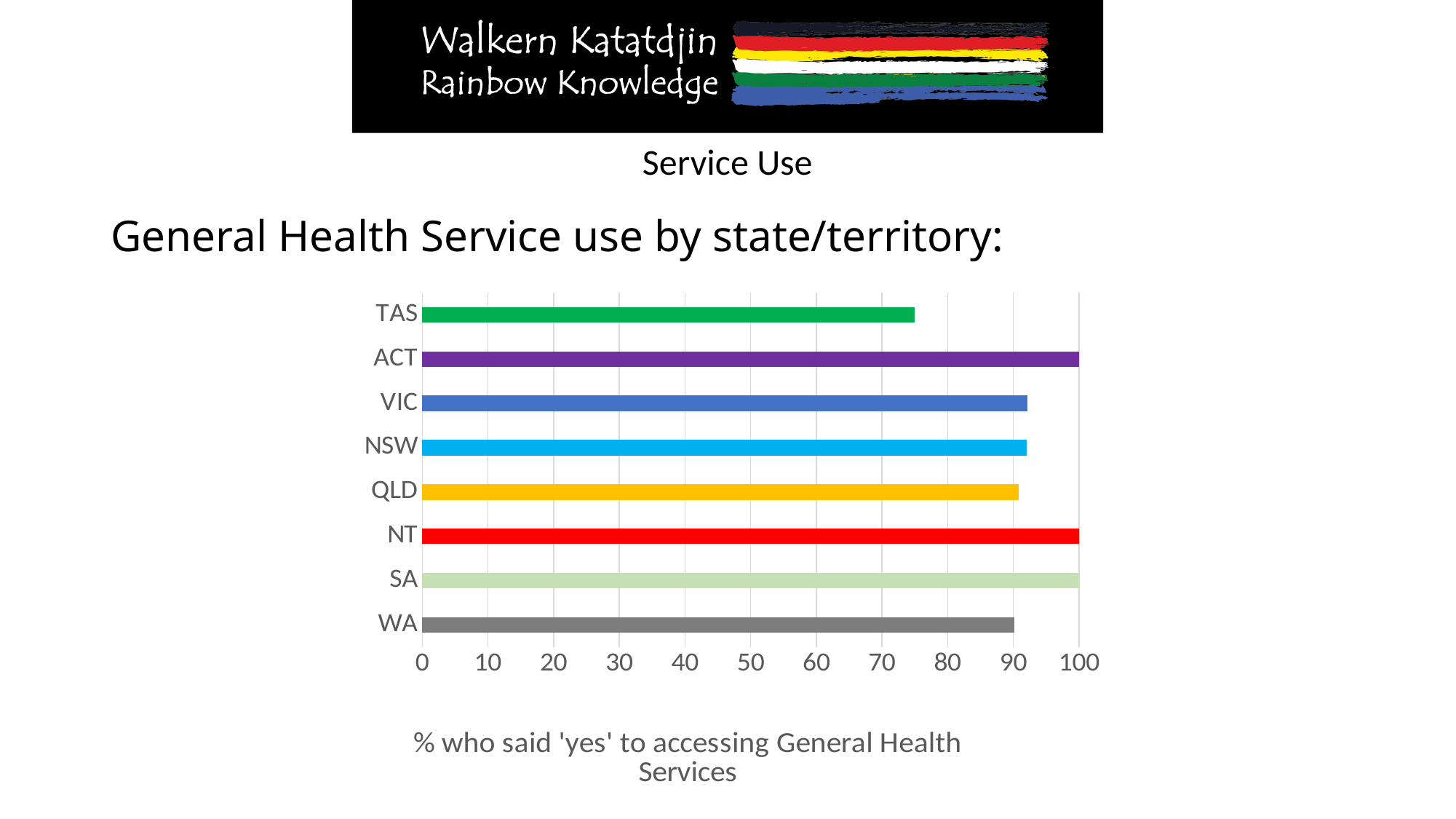
What is the value for NT? 100 Is the value for VIC greater or less than 90? greater How many states/territories are plotted in the chart? 8 Which state/territory has the lowest percentage of people who said 'yes' to accessing General Health Services? TAS What colour is the bar for NT? red What is the value for ACT? 100 Which has a higher value, TAS or WA? WA Is the value for TAS greater or less than 80? less What kind of chart is shown on the slide? bar chart What is the label on the horizontal axis of the chart? % who said 'yes' to accessing General Health Services What is the value for SA? 100